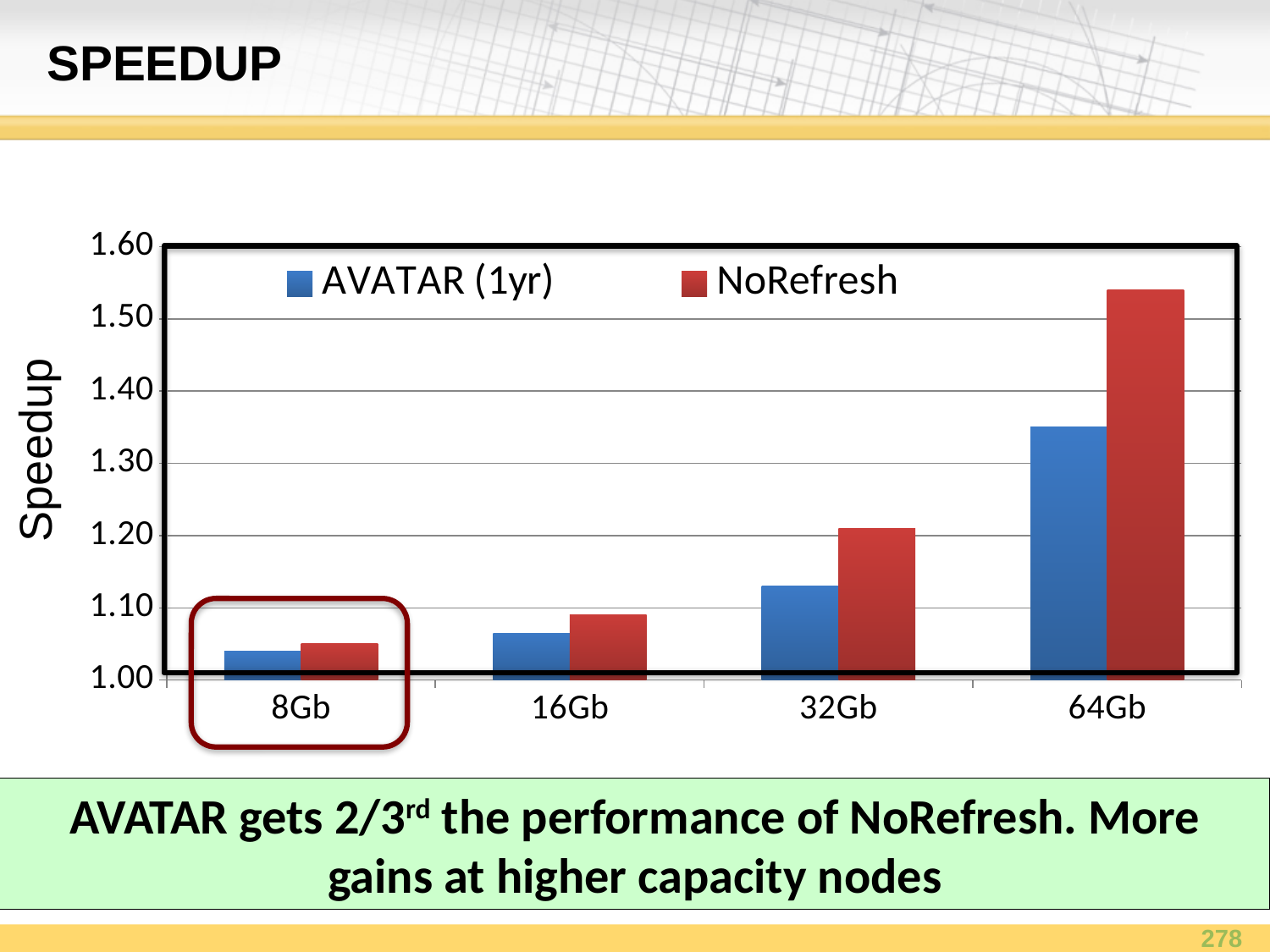
At 64Gb, which series has the larger speedup, AVATAR (1yr) or NoRefresh? NoRefresh How many capacity categories are shown on the x axis? 4 Is the NoRefresh speedup at 64Gb greater or less than 1.50? greater Do the speedup values for NoRefresh rise or fall as capacity increases from 8Gb to 64Gb? rise Which category has the highest NoRefresh speedup? 64Gb Which colour represents the NoRefresh series in the legend? red What kind of chart is shown on the slide? bar chart Is the AVATAR (1yr) speedup at 32Gb greater or less than 1.20? less Which category has the lowest AVATAR (1yr) speedup? 8Gb Is the AVATAR (1yr) speedup at 64Gb greater or less than 1.40? less What is the label on the y axis? Speedup How many series does the legend list? 2